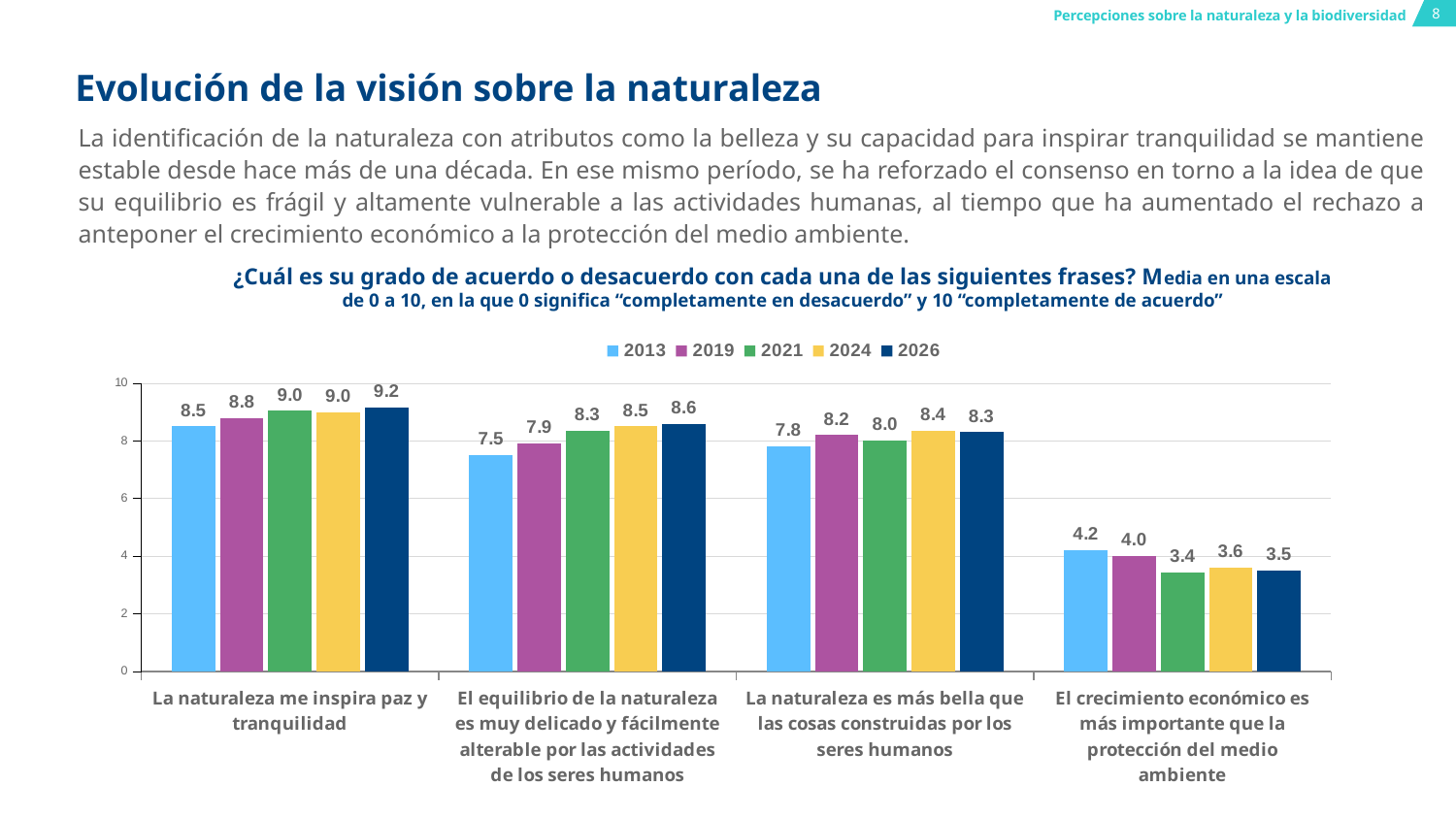
How many categories (statements) are shown on the x axis? 4 What is the 2021 value for "El crecimiento económico es más importante que la protección del medio ambiente"? 3.4 What is the difference between the 2026 and 2013 values for "El equilibrio de la naturaleza es muy delicado y fácilmente alterable por las actividades de los seres humanos"? 1.1 What kind of chart is shown on the slide? Bar chart Which statement has the highest 2013 value? La naturaleza me inspira paz y tranquilidad What is the 2013 value for "El equilibrio de la naturaleza es muy delicado y fácilmente alterable por las actividades de los seres humanos"? 7.5 Do the values for "El equilibrio de la naturaleza es muy delicado y fácilmente alterable por las actividades de los seres humanos" rise or fall from 2013 to 2026? Rise Which year is shown in dark blue in the legend? 2026 How many series does the legend list? 5 Which statement has the lowest 2026 value? El crecimiento económico es más importante que la protección del medio ambiente What is the 2026 value for "La naturaleza me inspira paz y tranquilidad"? 9.2 For "La naturaleza es más bella que las cosas construidas por los seres humanos", which is larger: the 2024 value or the 2026 value? 2024